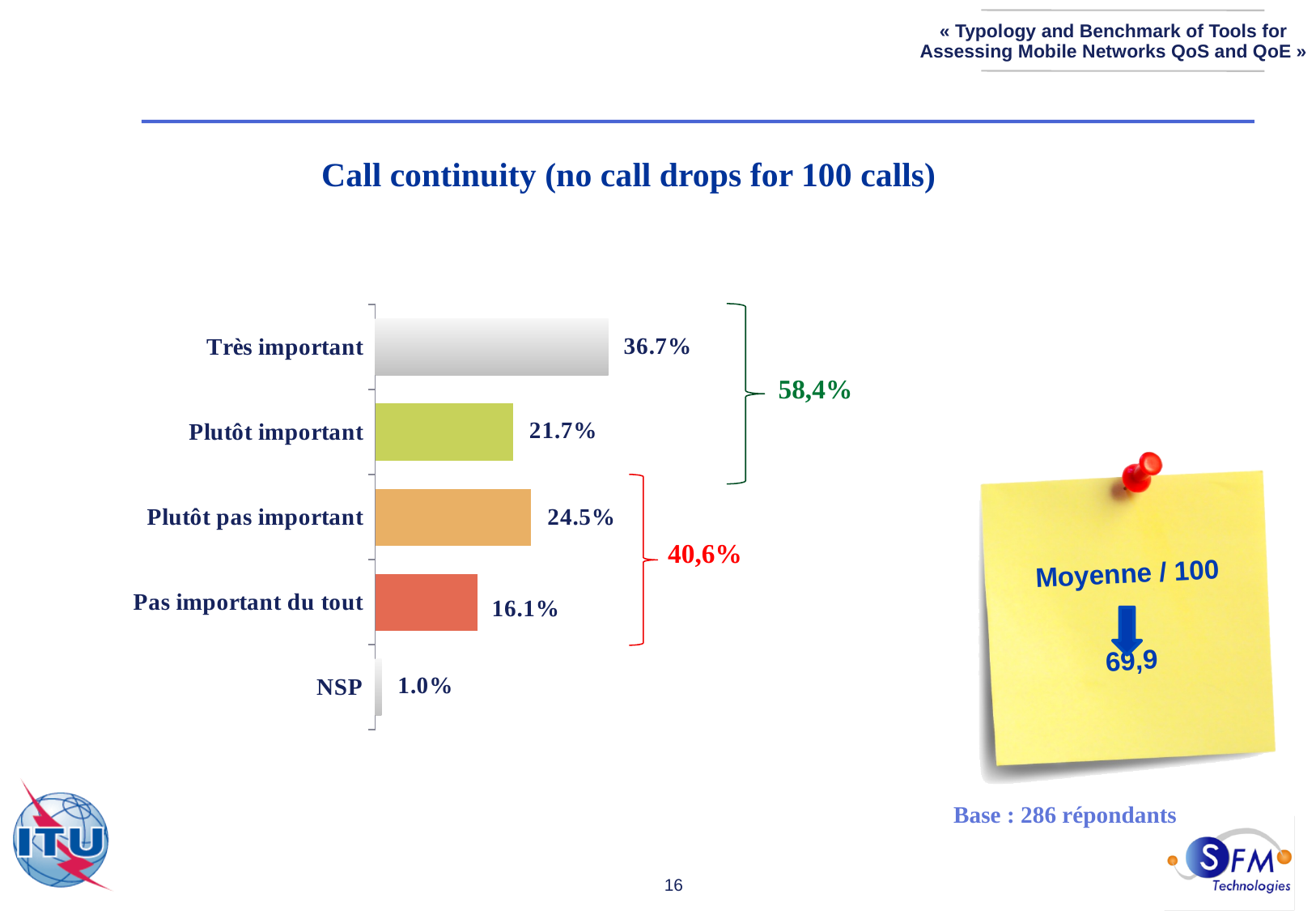
Which category has the lowest value? NSP What is the value for "Plutôt pas important"? 24.5% What kind of chart is shown on the slide? Bar chart What is the combined share shown for "Très important" and "Plutôt important"? 58,4% What is the value for "NSP"? 1.0% How many categories are shown in the chart? 5 What is the combined share shown for "Plutôt pas important" and "Pas important du tout"? 40,6% What is the title of the chart? Call continuity (no call drops for 100 calls) What is the value for "Très important"? 36.7% What is the difference between "Très important" and "Plutôt important"? 15.0% Which is larger, "Plutôt pas important" or "Pas important du tout"? Plutôt pas important Which category has the highest value? Très important